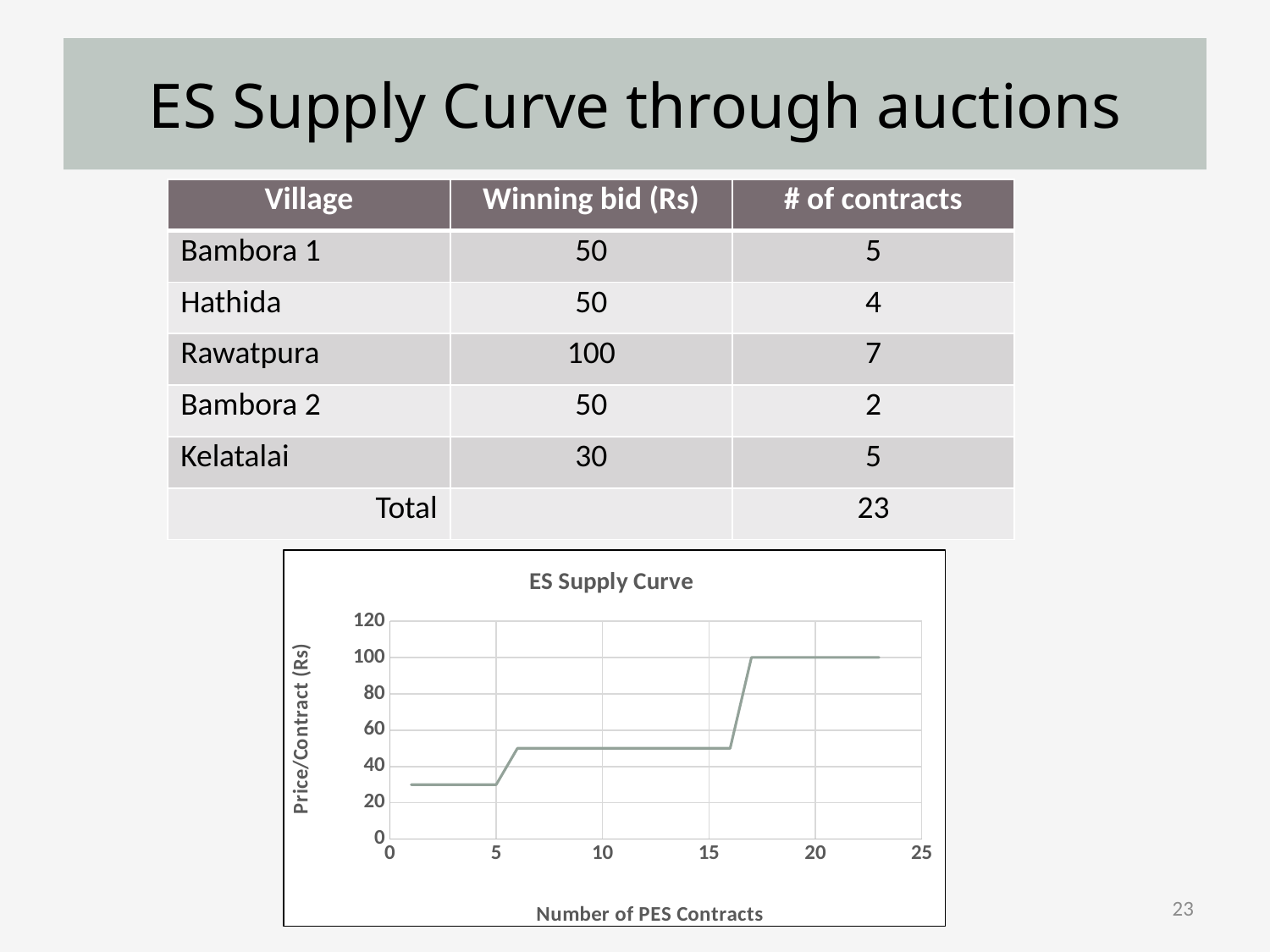
What is the label of the vertical axis in the ES Supply Curve chart? Price/Contract (Rs) In the ES Supply Curve chart, what is the highest price per contract the line reaches? 100 In the ES Supply Curve chart, is the price per contract at 15 contracts greater or less than 40? greater In the ES Supply Curve chart, which is lower: the price per contract at 3 contracts or at 15 contracts? 3 contracts In the ES Supply Curve chart, which is higher: the price per contract at 10 contracts or at 20 contracts? 20 contracts In the ES Supply Curve chart, is the price per contract at 20 contracts greater or less than 80? greater In the ES Supply Curve chart, does the price per contract rise or fall as the number of PES contracts increases? rise What kind of chart is the ES Supply Curve chart? line chart In the ES Supply Curve chart, is the price per contract at 10 contracts greater or less than 60? less What is the title of the chart on the slide? ES Supply Curve